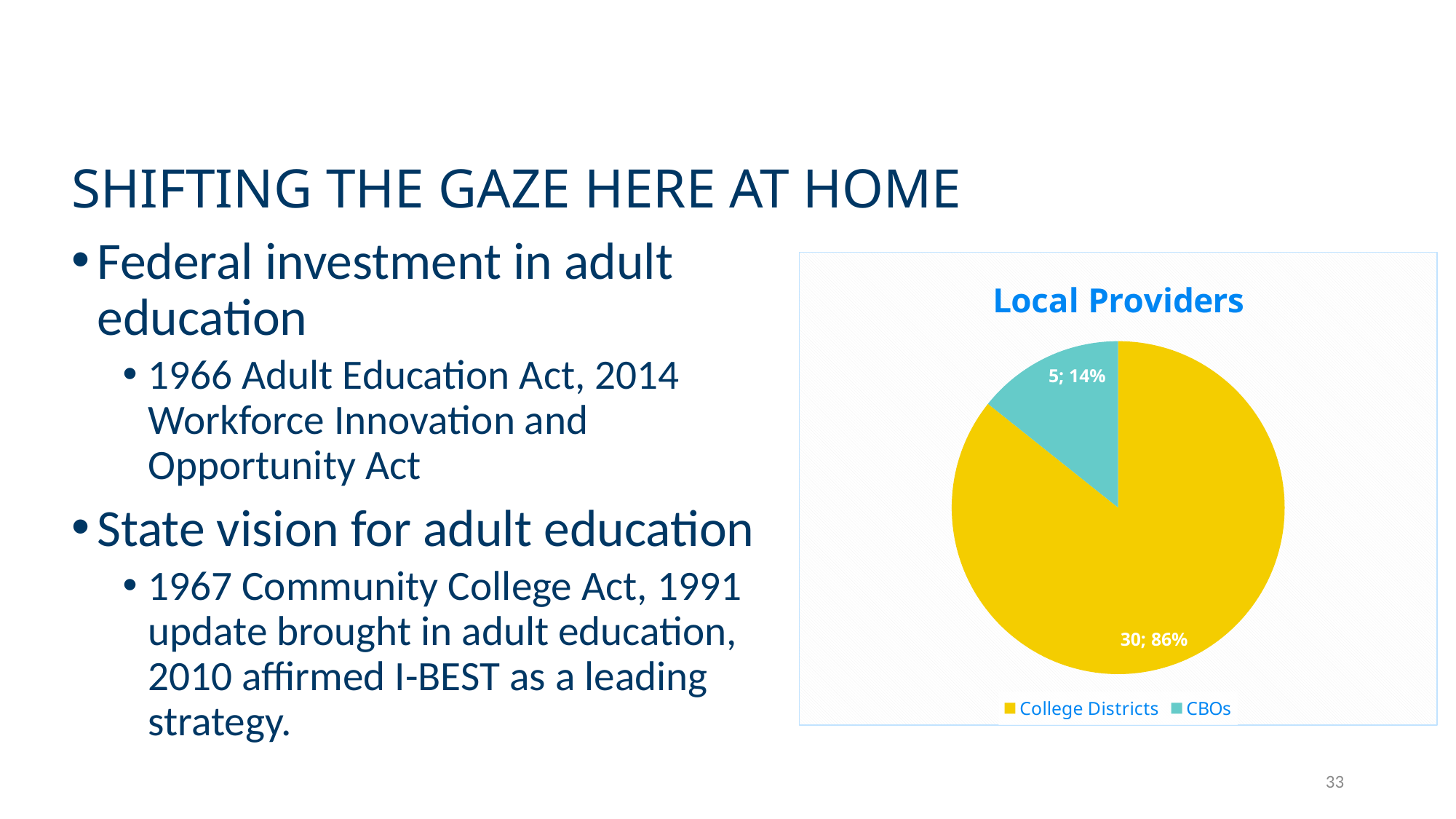
How many entries does the legend list? 2 What is the title of the chart? Local Providers What is the difference between the College Districts count and the CBOs count? 25 What share of the pie do CBOs make up? 14% What is the count for CBOs? 5 Which category has the largest slice? College Districts What kind of chart is shown on the slide? pie chart What share of the pie do College Districts make up? 86% How many slices does the pie chart have? 2 What is the count for College Districts? 30 Which colour represents CBOs in the chart? teal Which category has the smallest slice? CBOs